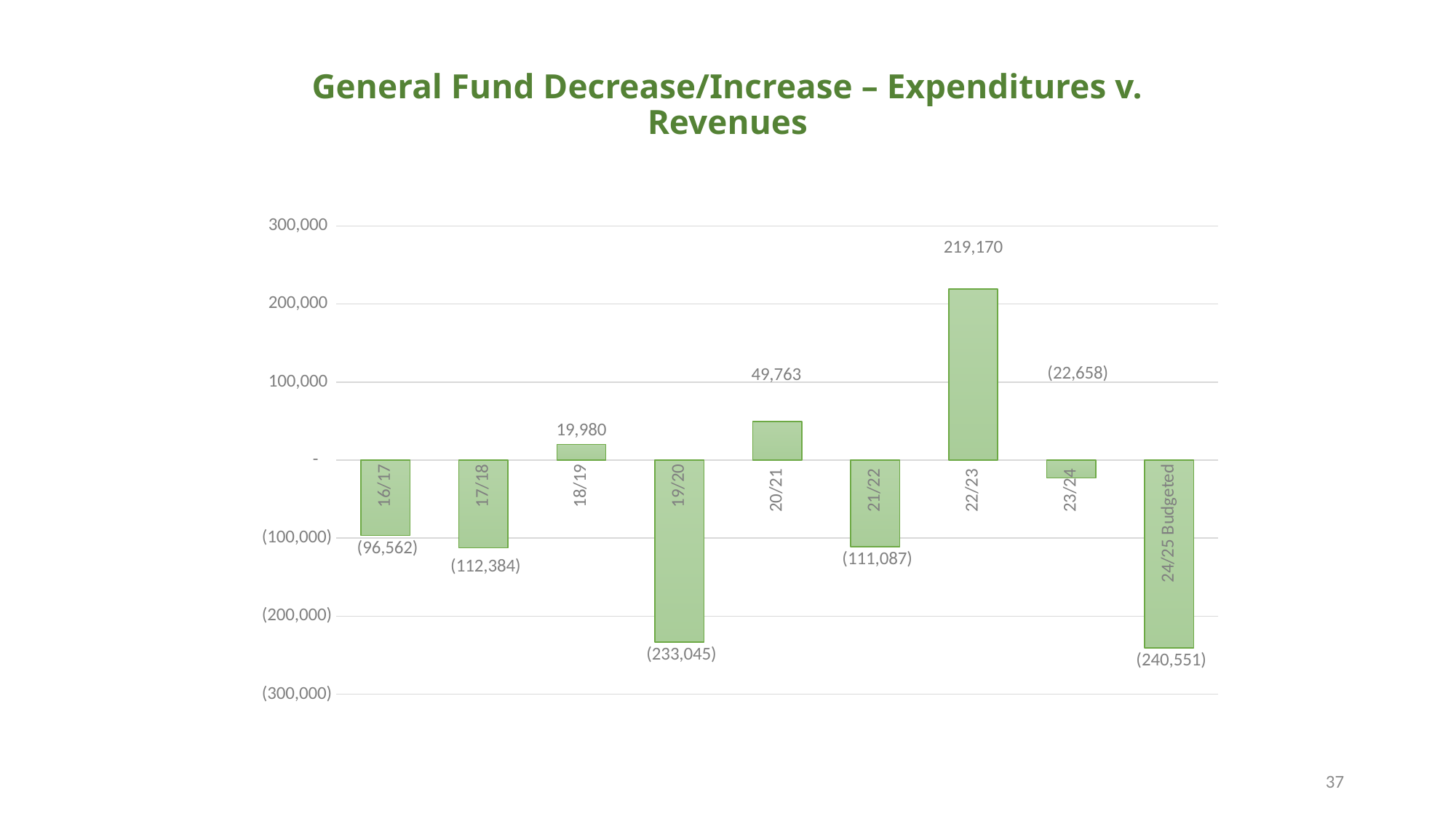
What is the title of the chart? General Fund Decrease/Increase – Expenditures v. Revenues What is the value for 18/19? 19,980 What kind of chart is this? bar chart Which year has the lowest value? 24/25 Budgeted What is the value for 19/20? (233,045) What is the value for 24/25 Budgeted? (240,551) Which year has the highest value? 22/23 How many years are shown on the x axis? 9 What is the value for 22/23? 219,170 Which is larger, the value for 20/21 or the value for 18/19? 20/21 Is the value for 22/23 greater or less than 200,000? greater What is the difference between the values for 22/23 and 20/21? 169,407